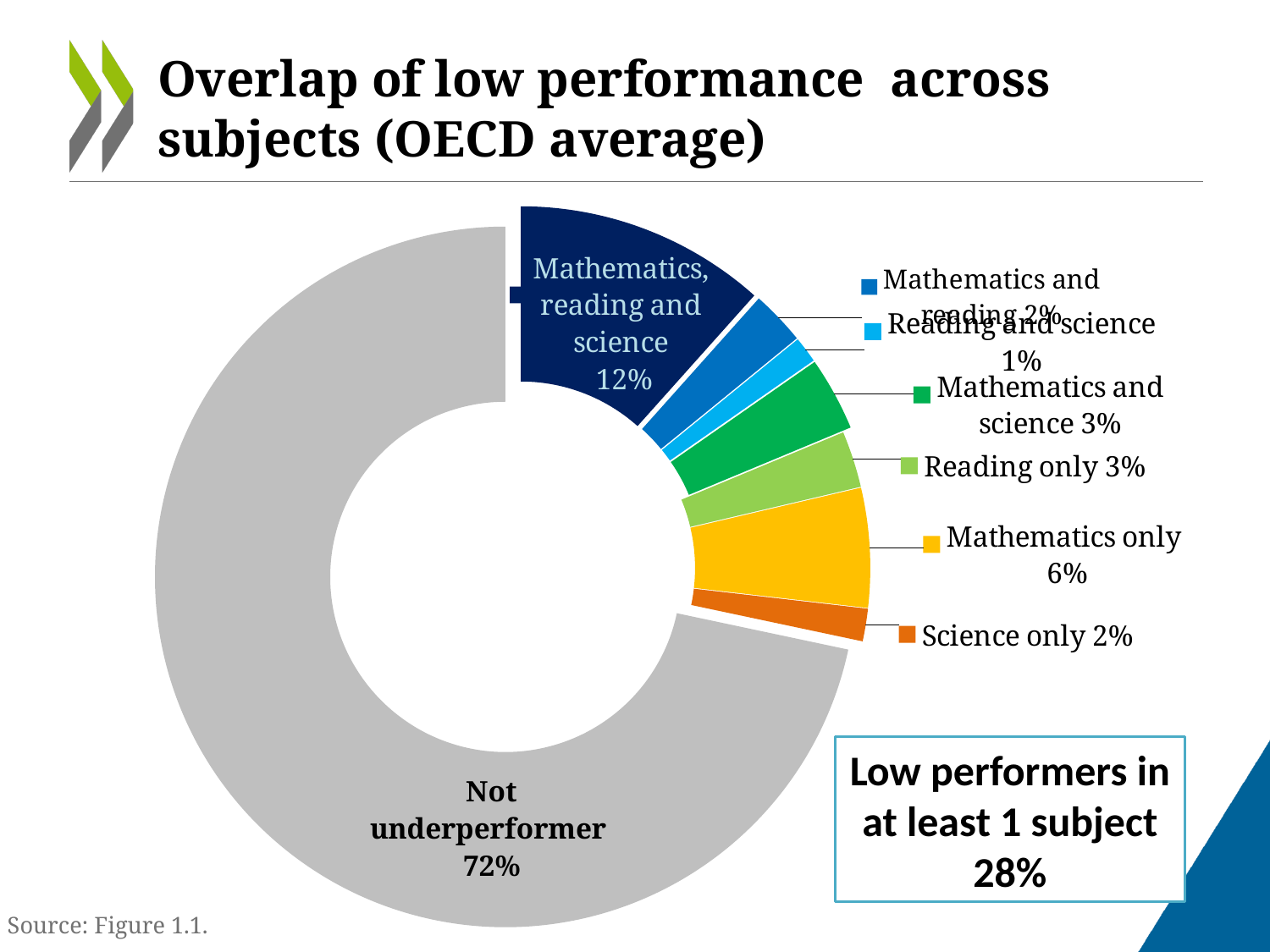
How many slices does the chart have? 8 What is the value shown for 'Reading and science'? 1% According to the slide, what share of students are low performers in at least 1 subject? 28% Which category has the smallest slice of the chart? Reading and science What percentage of students are low performers in mathematics, reading and science combined? 12% What colour is the 'Science only' slice? Orange Which is larger: 'Mathematics and science' or 'Mathematics and reading'? Mathematics and science What percentage of students are labelled 'Not underperformer' in the chart? 72% Which category has the largest slice of the chart? Not underperformer How much larger is the 'Mathematics only' share than the 'Science only' share? 4% What is the share for 'Mathematics only'? 6% What kind of chart is shown on the slide? Pie (doughnut) chart